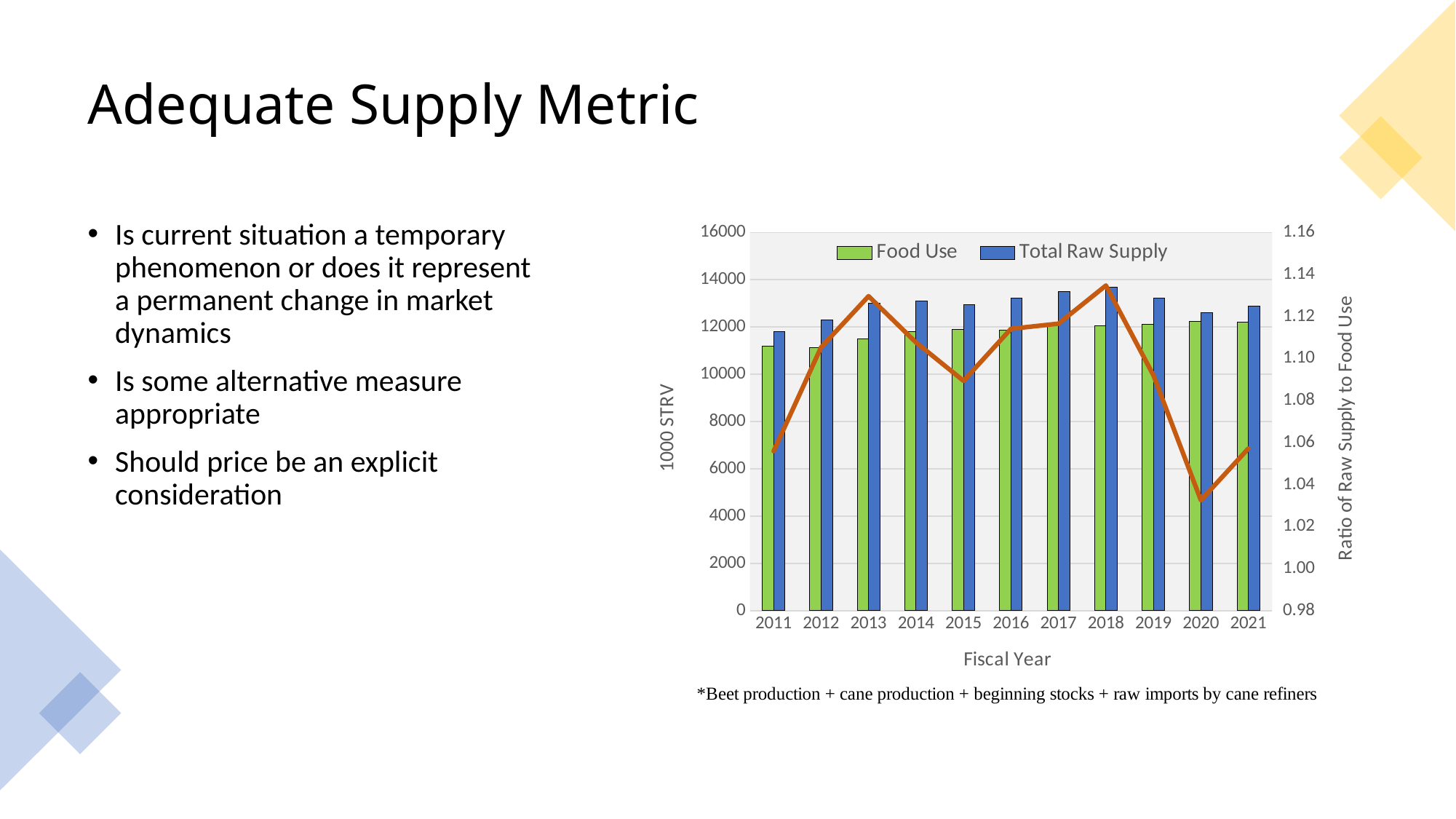
How many series does the chart's legend list? 2 Is the Total Raw Supply value for 2018 greater or less than 12000? greater What kind of chart is shown on the slide? A bar chart combined with a line Is the Food Use value for 2011 greater or less than 10000? greater Which series are listed in the chart's legend? Food Use and Total Raw Supply Which is larger, Food Use in 2021 or Food Use in 2011? Food Use in 2021 In which fiscal year is the Ratio of Raw Supply to Food Use line at its lowest? 2020 Is the Ratio of Raw Supply to Food Use for 2020 greater or less than 1.04? less In which fiscal year is Total Raw Supply the lowest? 2011 What is the title of the x axis of the chart? Fiscal Year How many fiscal years are shown on the x axis of the chart? 11